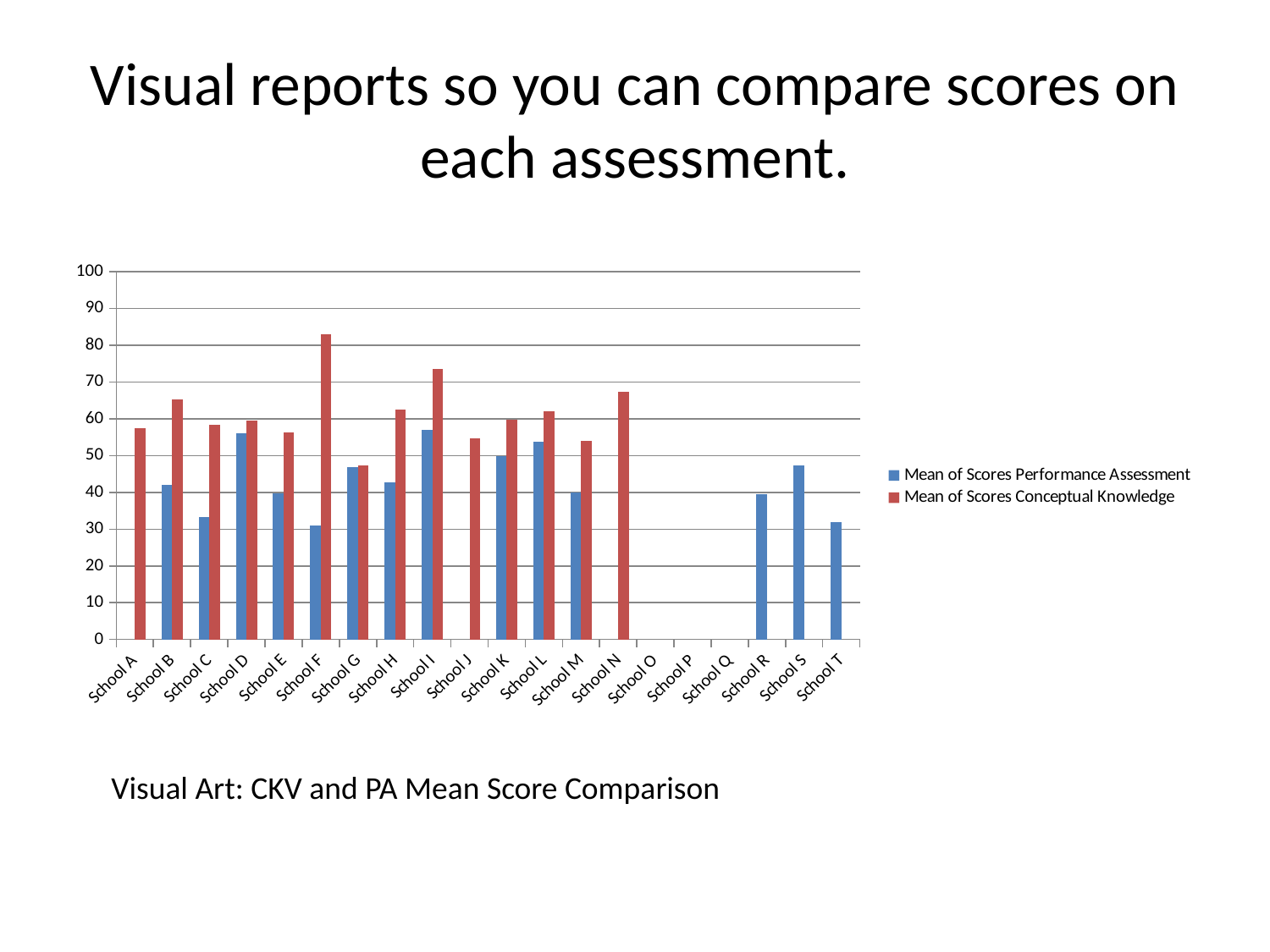
Which school has the lowest Mean of Scores Conceptual Knowledge among those with a Conceptual Knowledge bar? School G What caption appears below the chart? Visual Art: CKV and PA Mean Score Comparison What kind of chart is shown on the slide? bar chart Is the Mean of Scores Performance Assessment for School T greater or less than 40? less For School H, which is larger: Mean of Scores Performance Assessment or Mean of Scores Conceptual Knowledge? Mean of Scores Conceptual Knowledge Is the Mean of Scores Conceptual Knowledge for School I greater or less than 70? greater Which school has the highest Mean of Scores Conceptual Knowledge? School F Is the Mean of Scores Performance Assessment for School C greater or less than 40? less Which is larger: the Mean of Scores Conceptual Knowledge for School I or for School N? School I How many series does the legend list? 2 How many schools are listed along the x axis? 20